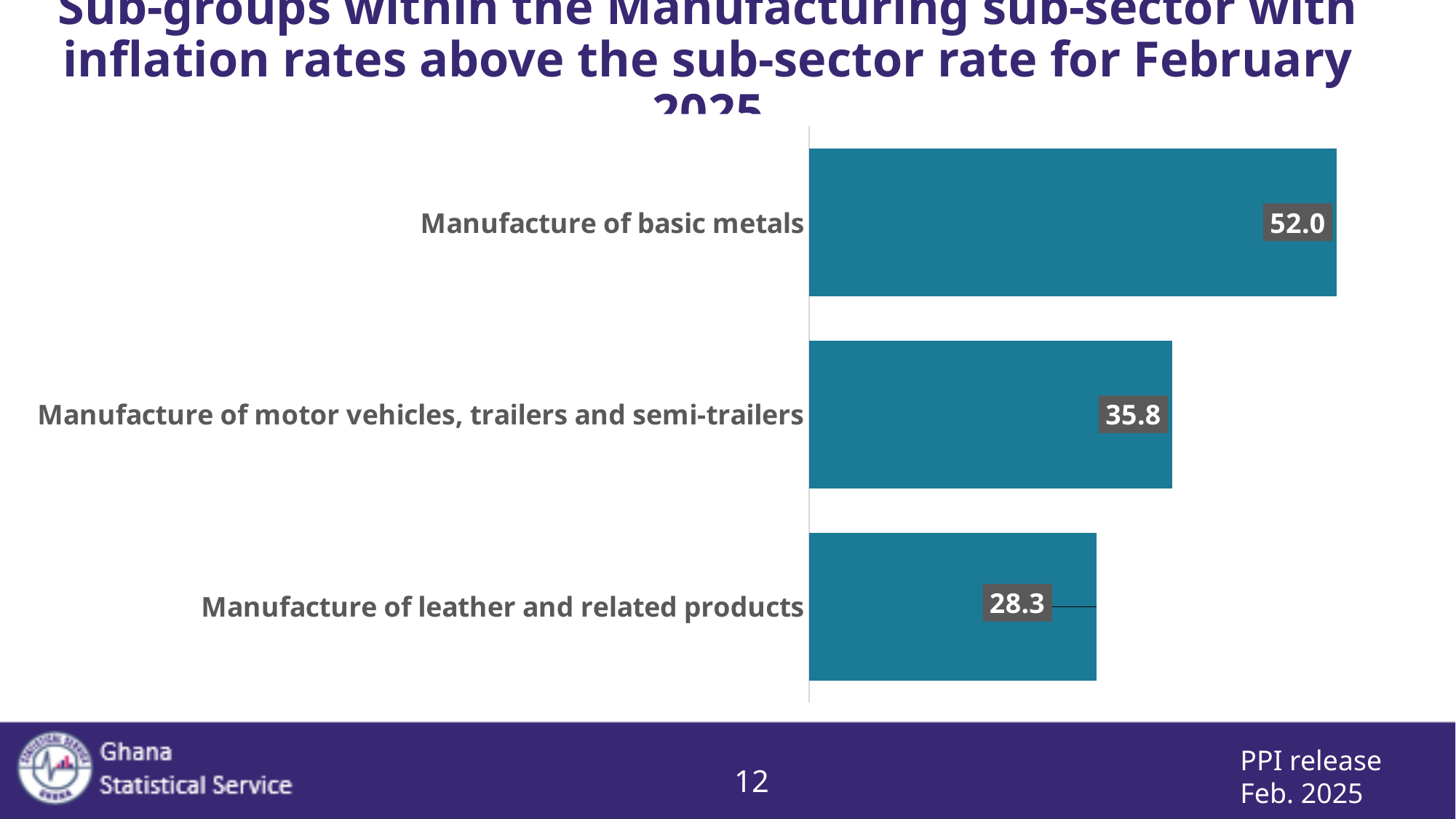
Which sub-group has the lowest inflation rate? Manufacture of leather and related products Which sub-group has the highest inflation rate? Manufacture of basic metals What is the difference between the inflation rates for Manufacture of basic metals and Manufacture of motor vehicles, trailers and semi-trailers? 16.2 What colour are the bars in the chart? Teal What is the difference between the inflation rates for Manufacture of motor vehicles, trailers and semi-trailers and Manufacture of leather and related products? 7.5 What is the inflation rate for Manufacture of leather and related products? 28.3 How many sub-groups are shown in the chart? 3 Are the bars in the chart horizontal or vertical? Horizontal What is the inflation rate for Manufacture of motor vehicles, trailers and semi-trailers? 35.8 What kind of chart is shown on the slide? Bar chart Which has a higher inflation rate: Manufacture of motor vehicles, trailers and semi-trailers or Manufacture of leather and related products? Manufacture of motor vehicles, trailers and semi-trailers What is the inflation rate for Manufacture of basic metals? 52.0